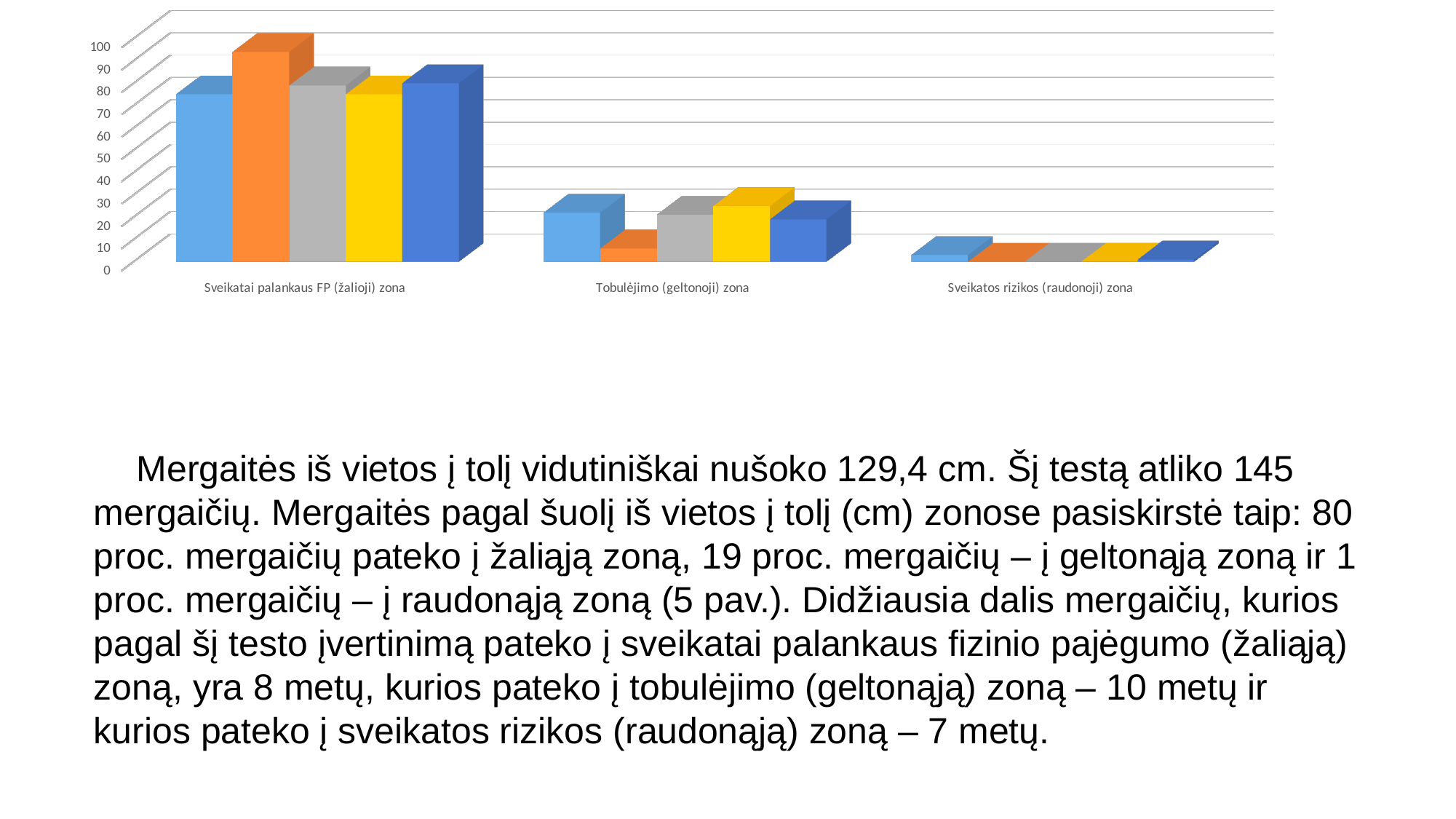
How many bars are plotted for each category in the chart? 5 Which category has the tallest bars in the chart? Sveikatai palankaus FP (žalioji) zona Which category has the shortest bars in the chart? Sveikatos rizikos (raudonoji) zona Is the orange bar larger for Sveikatai palankaus FP (žalioji) zona or for Tobulėjimo (geltonoji) zona? Sveikatai palankaus FP (žalioji) zona Is the value of the orange bar for Sveikatai palankaus FP (žalioji) zona greater or less than 80? greater How many categories are shown on the x axis of the chart? 3 What kind of chart is shown on the slide? bar chart Do the bar values generally rise or fall moving from left to right across the categories? fall Is the value of the light blue bar for Sveikatai palankaus FP (žalioji) zona greater or less than 60? greater Is the gray bar larger for Tobulėjimo (geltonoji) zona or for Sveikatos rizikos (raudonoji) zona? Tobulėjimo (geltonoji) zona Is the value of the orange bar for Tobulėjimo (geltonoji) zona greater or less than 20? less